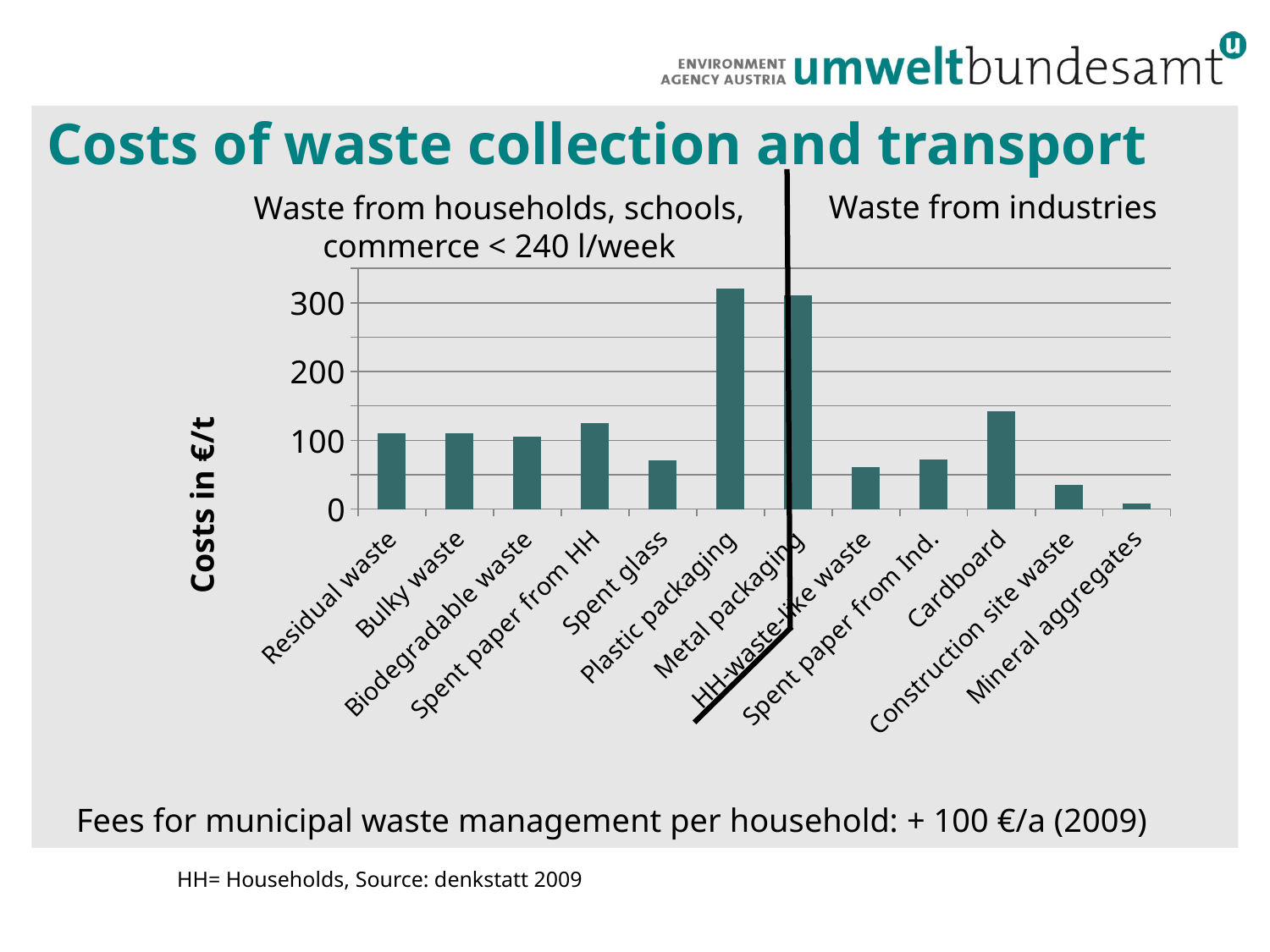
What kind of chart is shown on the slide? bar chart Which has the higher cost, Cardboard or Spent glass? Cardboard What is the label of the y axis? Costs in €/t How many waste categories are plotted on the x axis? 12 Which waste category has the lowest cost in €/t? Mineral aggregates Is the value for Cardboard greater or less than 100? greater What is the title of the chart? Costs of waste collection and transport Is the value for Construction site waste greater or less than 100? less Is the value for Plastic packaging greater or less than 300? greater Which has the higher cost, Residual waste or Construction site waste? Residual waste